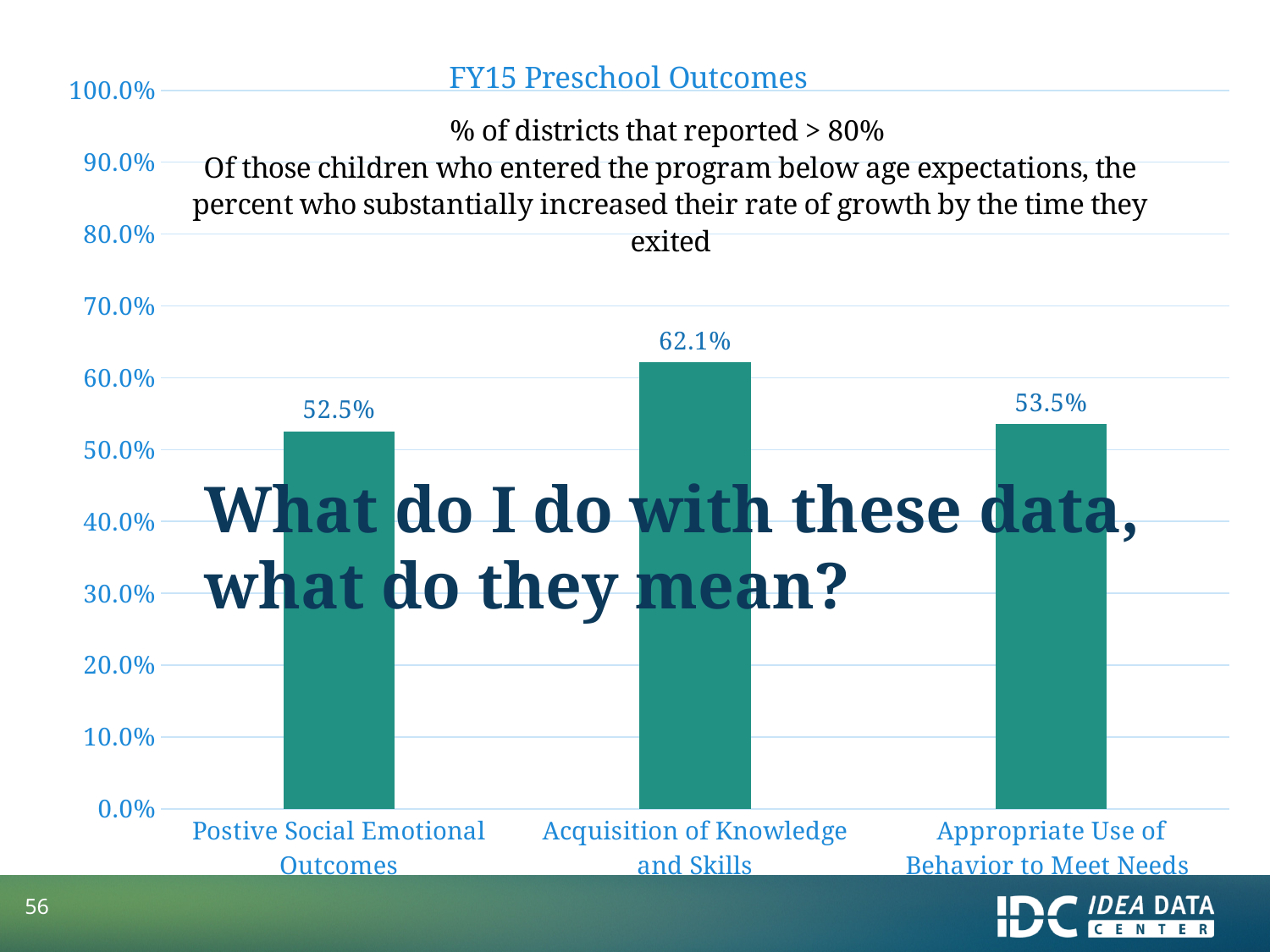
Is the value for Acquisition of Knowledge and Skills greater or less than 60.0%? greater Which is larger, the value for Acquisition of Knowledge and Skills or the value for Appropriate Use of Behavior to Meet Needs? Acquisition of Knowledge and Skills What is the difference between the values for Acquisition of Knowledge and Skills and Postive Social Emotional Outcomes? 9.6% What is the title of the chart? FY15 Preschool Outcomes What is the value for Acquisition of Knowledge and Skills? 62.1% Which category has the highest value? Acquisition of Knowledge and Skills What is the value for Postive Social Emotional Outcomes? 52.5% How many categories are shown on the chart? 3 What kind of chart is shown on the slide? bar chart What is the difference between the values for Appropriate Use of Behavior to Meet Needs and Postive Social Emotional Outcomes? 1.0% Which category has the lowest value? Postive Social Emotional Outcomes What is the value for Appropriate Use of Behavior to Meet Needs? 53.5%